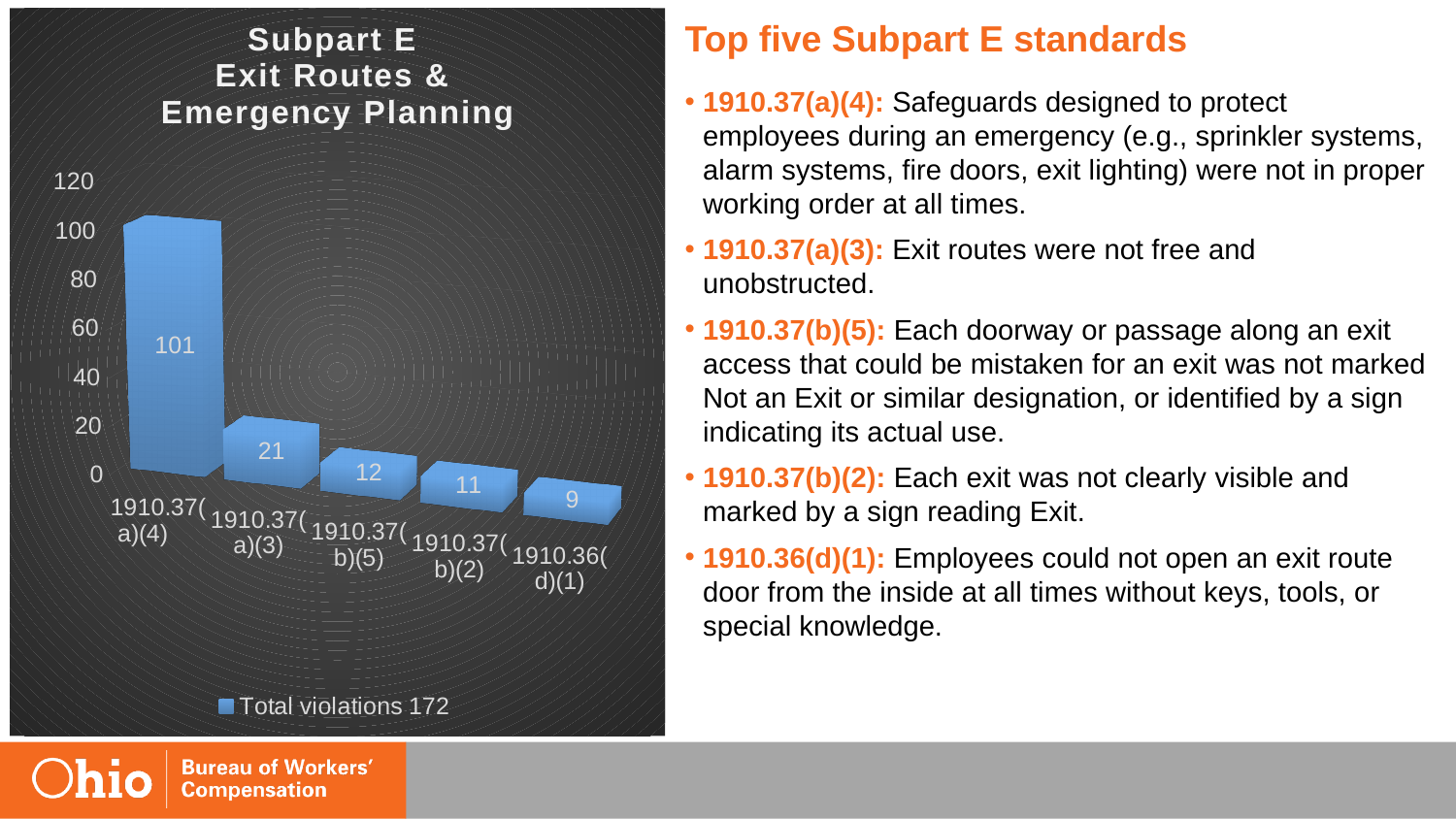
What is the value for 1910.37(a)(4)? 101 What is the value for 1910.37(b)(5)? 12 Is the value for 1910.37(a)(4) greater or less than 80? greater Which category has the lowest value? 1910.36(d)(1) What is the difference between the values for 1910.37(a)(4) and 1910.37(a)(3)? 80 Which category has the highest value? 1910.37(a)(4) What is the legend entry for the series? Total violations 172 How many categories are shown on the x axis? 5 What kind of chart is this? bar chart What is the value for 1910.36(d)(1)? 9 Which is larger, the value for 1910.37(a)(3) or the value for 1910.37(b)(5)? 1910.37(a)(3) What is the difference between the values for 1910.37(b)(2) and 1910.36(d)(1)? 2